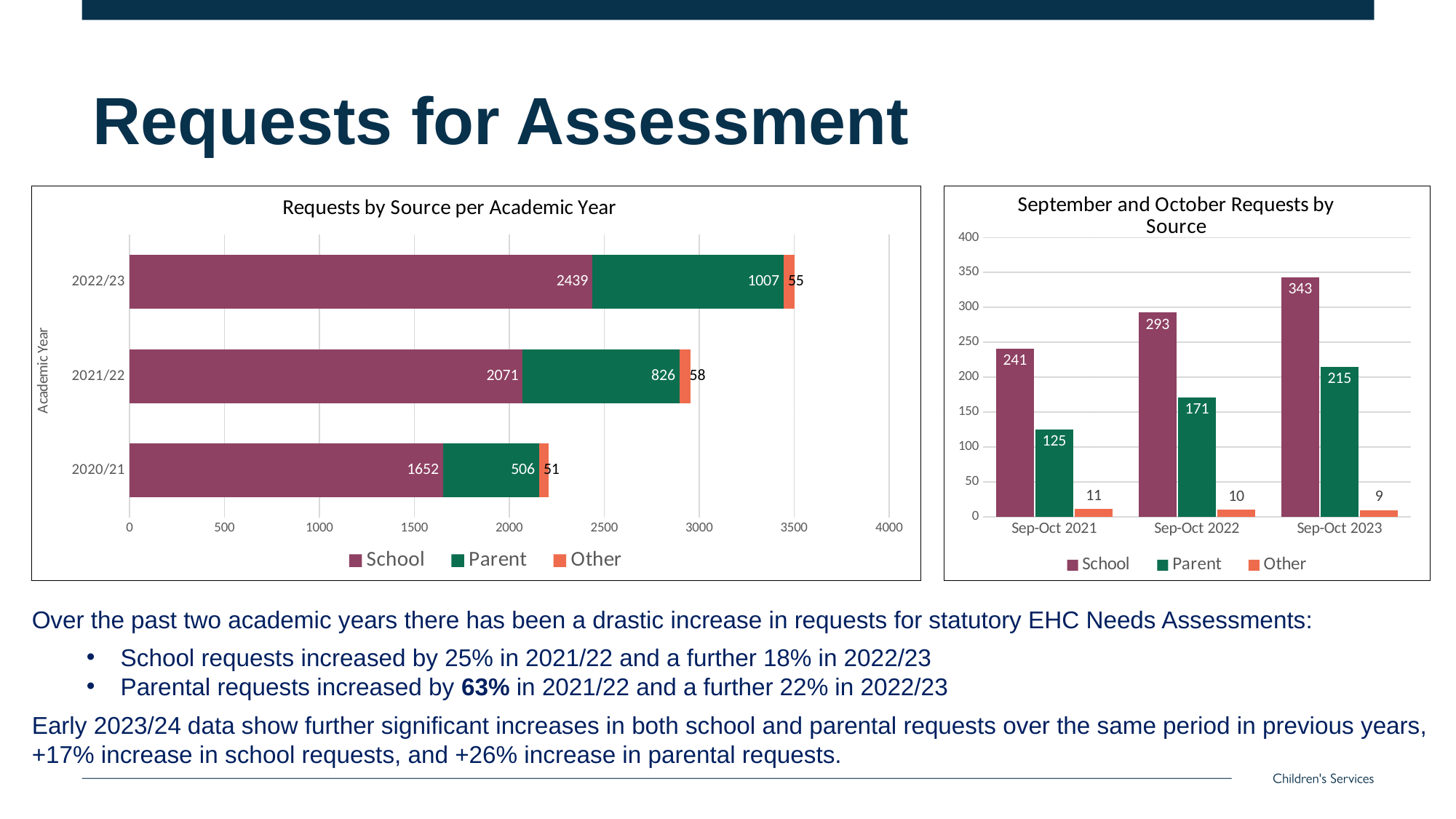
In the 'September and October Requests by Source' chart, do the School values rise or fall from Sep-Oct 2021 to Sep-Oct 2023? Rise In the 'September and October Requests by Source' chart, what is the Parent value for Sep-Oct 2022? 171 How many series does the legend of the 'September and October Requests by Source' chart list? 3 In the 'Requests by Source per Academic Year' chart, what is the difference between the School values for 2022/23 and 2021/22? 368 In the 'September and October Requests by Source' chart, which period has the lowest Other value? Sep-Oct 2023 In the 'Requests by Source per Academic Year' chart, which academic year has the highest Other value? 2021/22 In the 'Requests by Source per Academic Year' chart, what is the total of the stacked bar for 2021/22? 2955 In the 'Requests by Source per Academic Year' chart, what is the School value for 2022/23? 2439 In the 'September and October Requests by Source' chart, what is the difference between the School values for Sep-Oct 2023 and Sep-Oct 2021? 102 What kind of chart is 'Requests by Source per Academic Year'? Stacked bar chart In the 'Requests by Source per Academic Year' chart, what is the Parent value for 2020/21? 506 In the 'September and October Requests by Source' chart, how many periods are shown on the x axis? 3